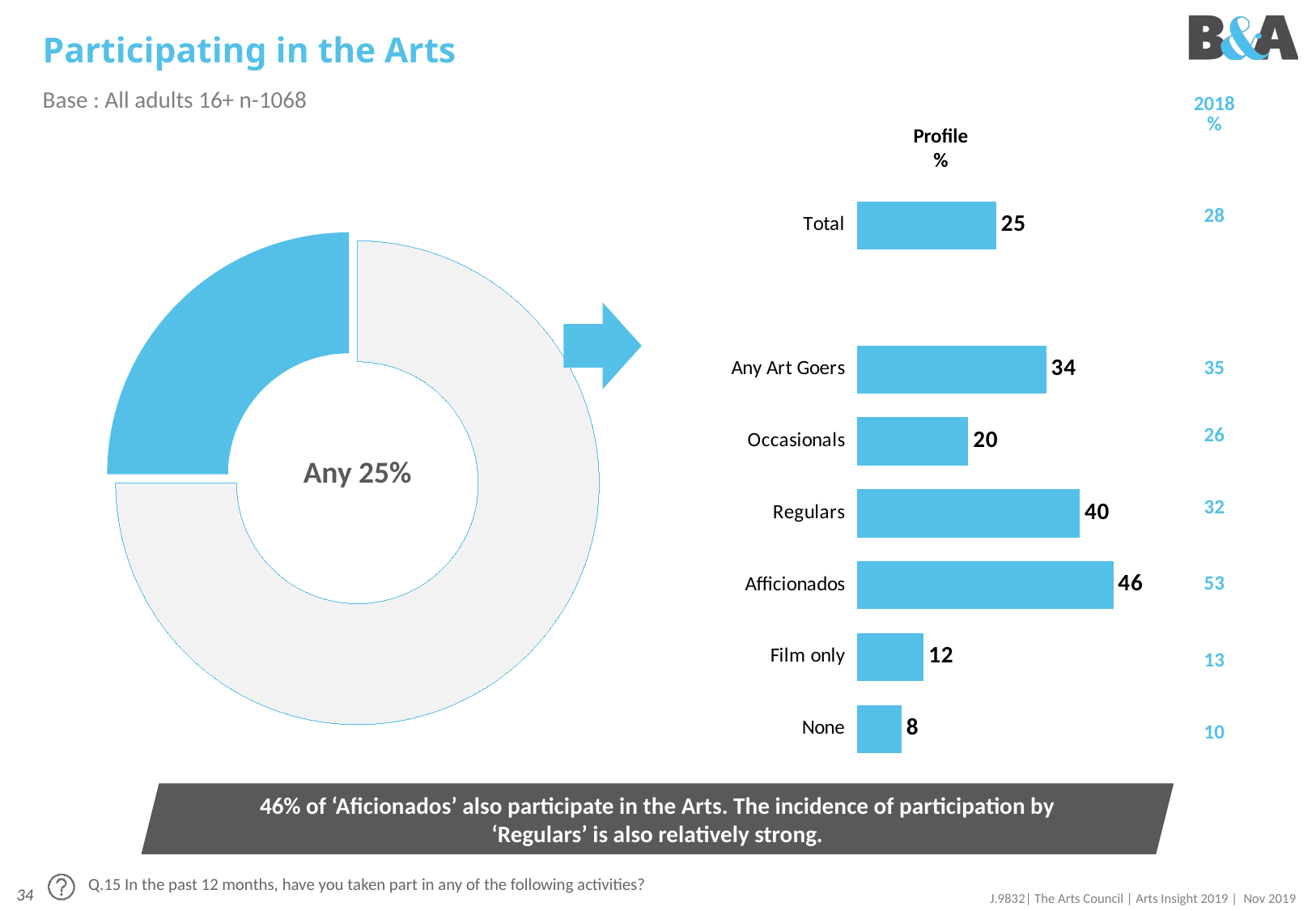
How many categories are shown in the bar chart? 7 What percentage is shown in the centre of the donut chart? Any 25% In the 2018 % column, what is the value for Afficionados? 53 In the bar chart, what is the difference between the Profile % values for Afficionados and Regulars? 6 In the bar chart, which category has the lowest Profile % value? None In the bar chart, what is the Profile % value for Regulars? 40 In the bar chart, which has a larger Profile % value, Regulars or Any Art Goers? Regulars In the bar chart, what is the difference between the Profile % values for Any Art Goers and Occasionals? 14 In the bar chart, what is the Profile % value for Occasionals? 20 In the bar chart, what is the Profile % value for Film only? 12 What kind of chart is shown on the left of the slide? Donut chart In the bar chart, which category has the highest Profile % value? Afficionados